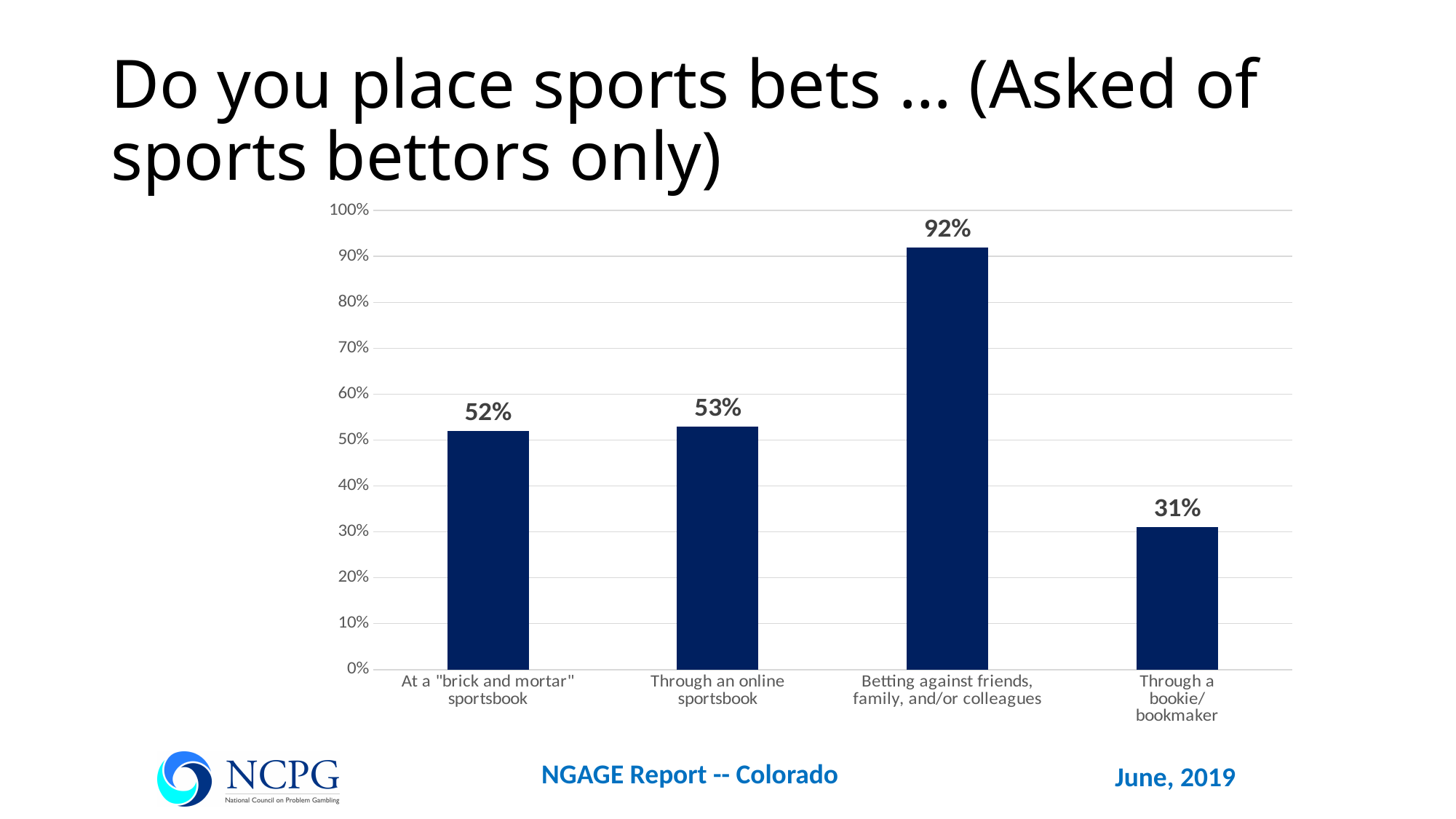
What percentage of sports bettors place bets through a bookie/bookmaker? 31% Which is larger: the percentage for betting against friends, family, and/or colleagues or the percentage for a "brick and mortar" sportsbook? Betting against friends, family, and/or colleagues Which category has the highest percentage? Betting against friends, family, and/or colleagues What is the difference in percentage points between betting through an online sportsbook and at a "brick and mortar" sportsbook? 1 percentage point What is the difference in percentage points between betting against friends, family, and/or colleagues and betting through a bookie/bookmaker? 61 percentage points What kind of chart is shown on the slide? Bar chart What percentage of sports bettors place bets through an online sportsbook? 53% What is the maximum value shown on the vertical axis? 100% What percentage of sports bettors bet against friends, family, and/or colleagues? 92% Which category has the lowest percentage? Through a bookie/bookmaker What percentage of sports bettors place bets at a "brick and mortar" sportsbook? 52% How many categories are shown on the chart? 4